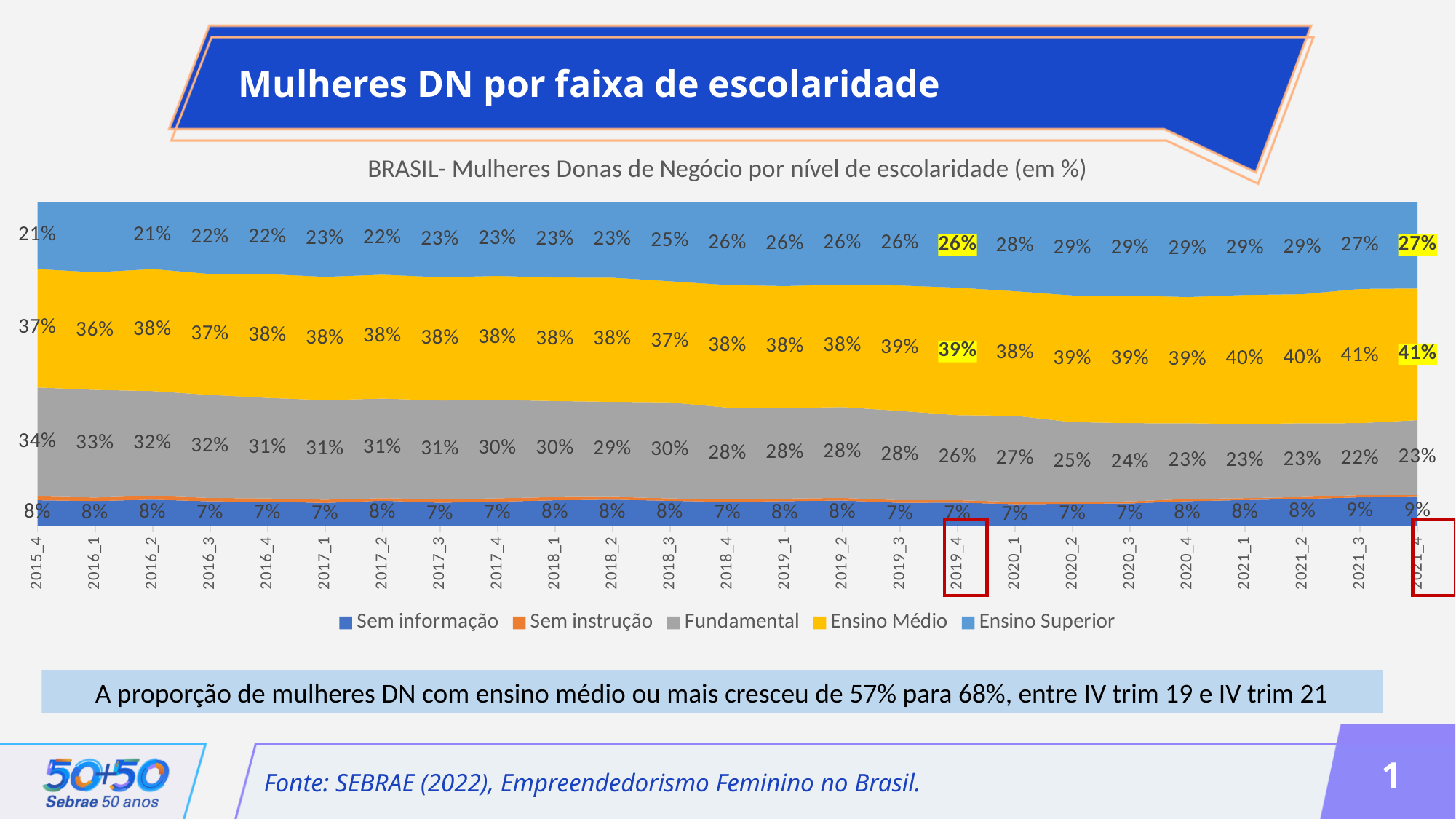
What is the value for Fundamental in 2015_4? 34% In 2021_4, which is larger: Ensino Médio or Fundamental? Ensino Médio What is the value for Sem informação in 2021_4? 9% What is the value for Ensino Médio in 2019_4? 39% How many quarters are shown along the x axis? 25 In which quarter is the Fundamental share highest? 2015_4 How many series does the legend list? 5 What is the value for Ensino Médio in 2021_4? 41% What is the value for Ensino Superior in 2019_4? 26% By how many percentage points did the Fundamental share fall from 2015_4 to 2021_4? 11 percentage points What kind of chart is shown on the slide? Stacked area chart Does the Fundamental share rise or fall from 2015_4 to 2021_4? Fall